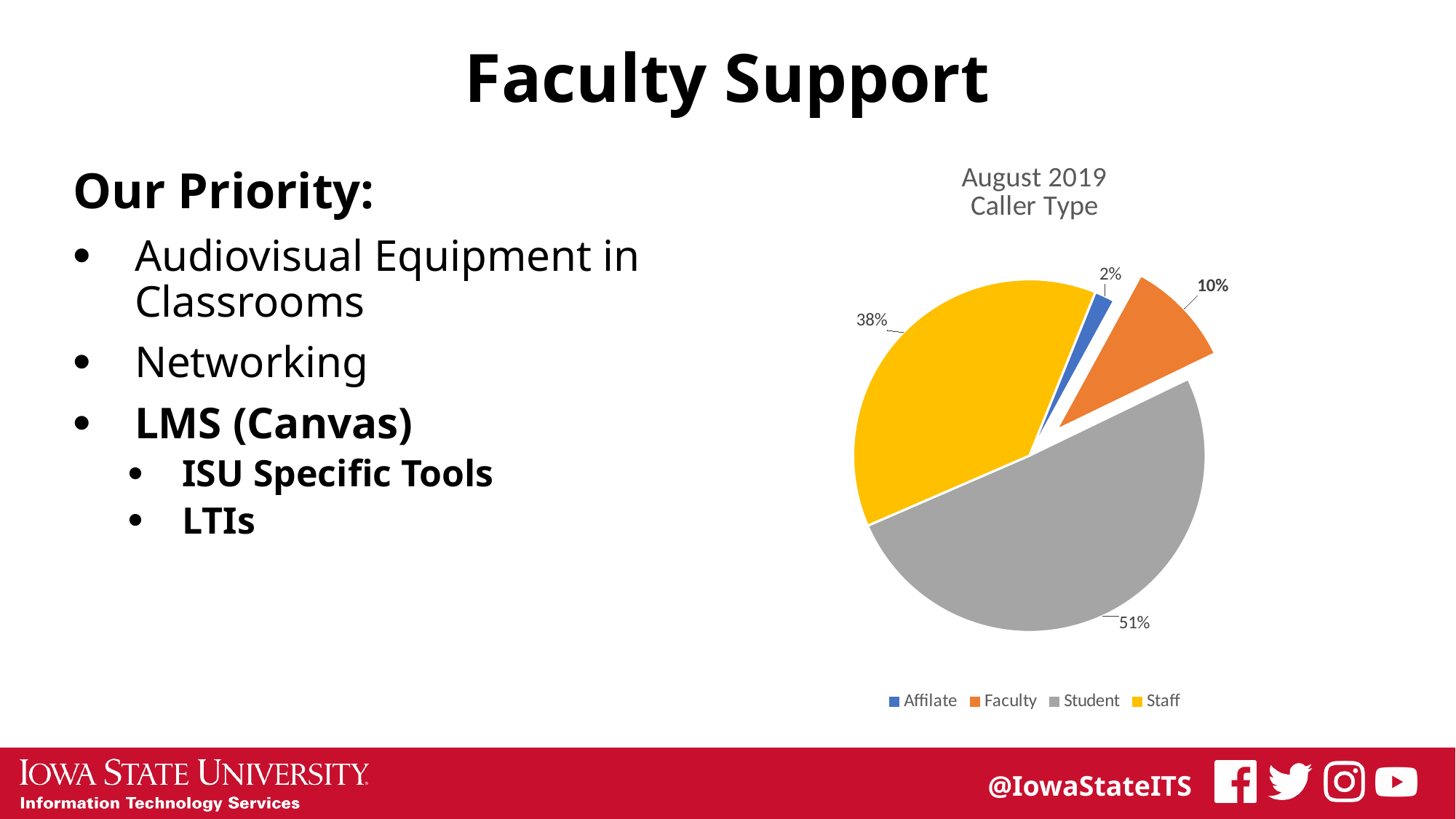
What percentage of callers were Affilate? 2% What colour represents Staff in the pie chart? yellow What percentage of callers were Staff? 38% How many caller types does the legend list? 4 Which is larger, the Faculty share or the Affilate share? Faculty What percentage of callers were Faculty? 10% What type of chart is shown on the slide? pie chart Which caller type has the smallest share of the pie? Affilate What is the title of the chart? August 2019 Caller Type Which caller type has the largest share of the pie? Student What percentage of callers were Students? 51% What is the difference in percentage points between the Student and Staff shares? 13